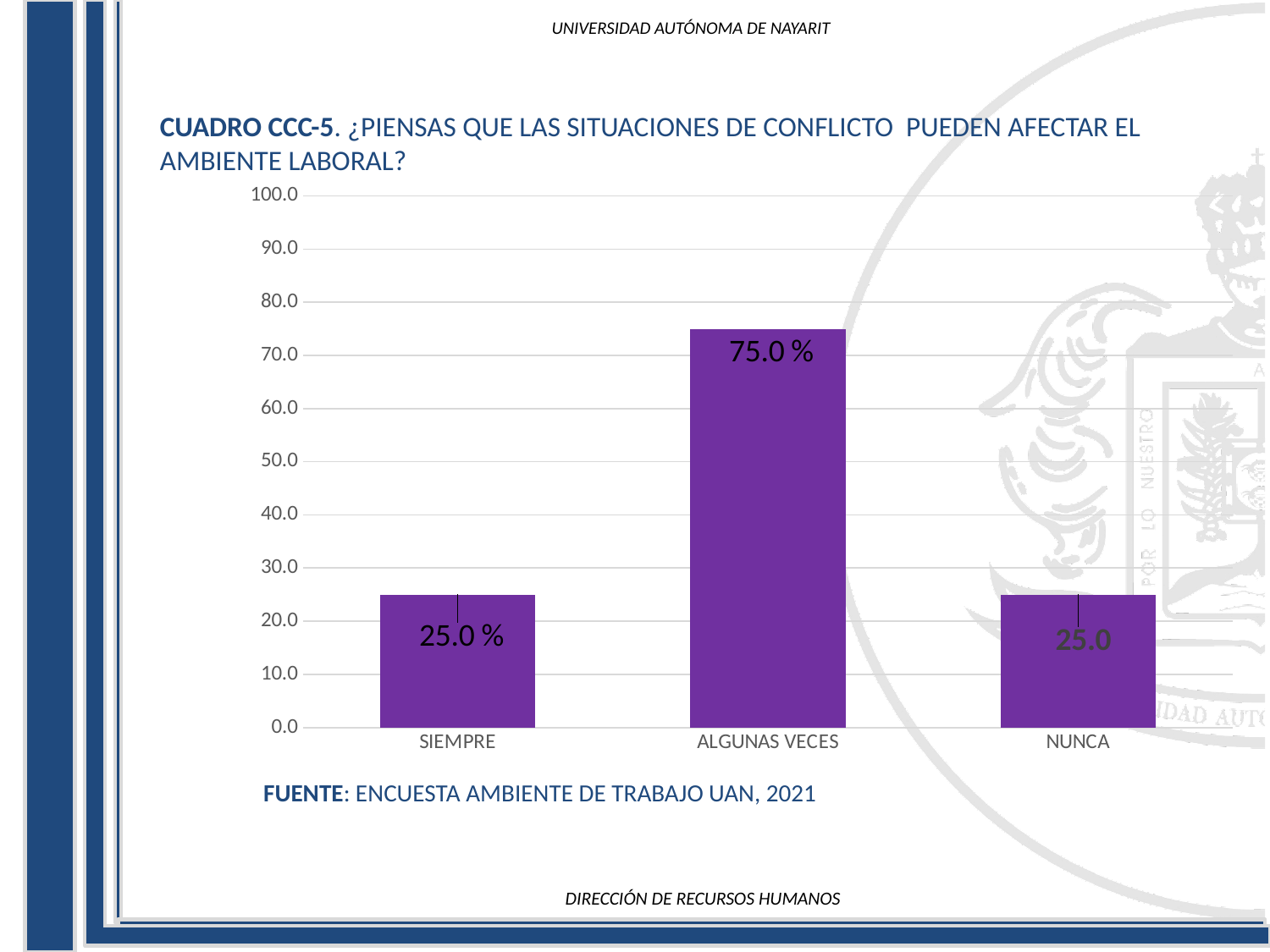
Is the value for ALGUNAS VECES greater or less than 50.0? greater Which is larger, the value for ALGUNAS VECES or the value for NUNCA? ALGUNAS VECES What is the value for SIEMPRE? 25.0 % What is the value for ALGUNAS VECES? 75.0 % Is the value for SIEMPRE greater or less than 40.0? less Which category has the highest value? ALGUNAS VECES What is the maximum value shown on the y axis? 100.0 What is the value shown on the NUNCA bar? 25.0 What kind of chart is shown on the slide? bar chart What is the source cited below the chart? ENCUESTA AMBIENTE DE TRABAJO UAN, 2021 How many categories are shown on the x axis? 3 What is the difference between the values for ALGUNAS VECES and SIEMPRE? 50.0 %